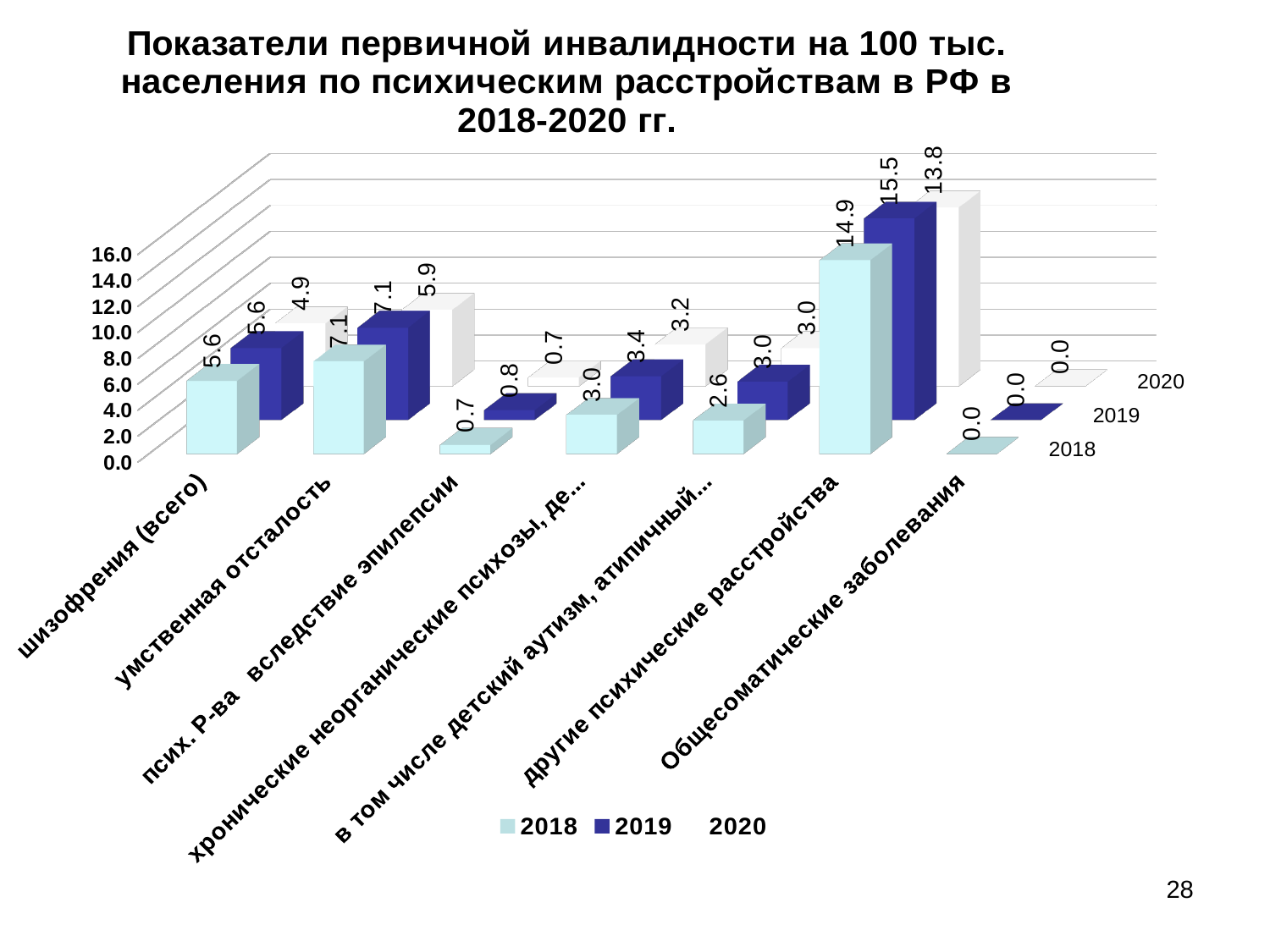
What kind of chart is shown on the slide? bar chart Which is larger: the 2018 value for умственная отсталость or the 2018 value for шизофрения (всего)? умственная отсталость What is the 2019 value for псих. Р-ва вследствие эпилепсии? 0.8 Which category has the highest value in the 2020 series? другие психические расстройства What is the difference between the 2019 and 2020 values for другие психические расстройства? 1.7 How many categories are shown on the x axis? 7 Which category has the lowest value in the 2018 series? Общесоматические заболевания What is the 2018 value for в том числе детский аутизм, атипичный...? 2.6 What is the 2020 value for умственная отсталость? 5.9 What is the 2019 value for другие психические расстройства? 15.5 How many series does the legend list? 3 What is the difference between the 2018 and 2020 values for шизофрения (всего)? 0.7